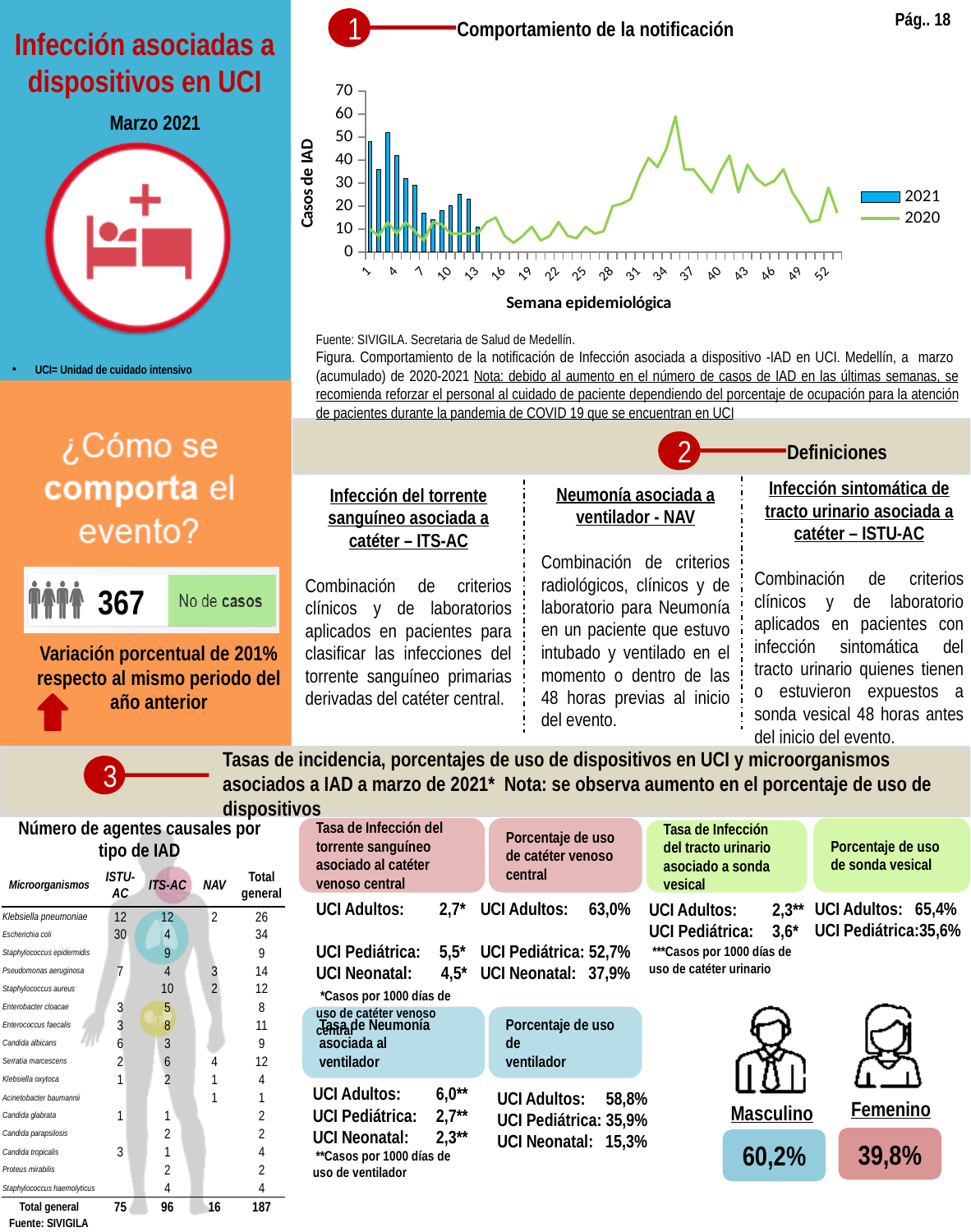
What is the title of the x axis of the "Comportamiento de la notificación" chart? Semana epidemiológica In the "Comportamiento de la notificación" chart, which week has the highest 2021 bar? Week 3 In the "Comportamiento de la notificación" chart, which is larger for 2020: the value at week 35 or the value at week 16? Week 35 In the "Comportamiento de la notificación" chart, which series is drawn as bars? 2021 What kind of chart is shown under "Comportamiento de la notificación"? A combined bar and line chart In the "Comportamiento de la notificación" chart, which is larger for 2021: the value for week 1 or the value for week 8? Week 1 In the "Comportamiento de la notificación" chart, do the 2021 bars generally rise or fall from week 1 to week 9? Fall In the "Comportamiento de la notificación" chart, is the 2021 value for week 2 greater or less than 40? less In the "Comportamiento de la notificación" chart, is the highest point of the 2020 line greater or less than 50? greater How many series does the legend of the "Comportamiento de la notificación" chart list? 2 In the "Comportamiento de la notificación" chart, is the 2020 value for week 16 greater or less than 20? less